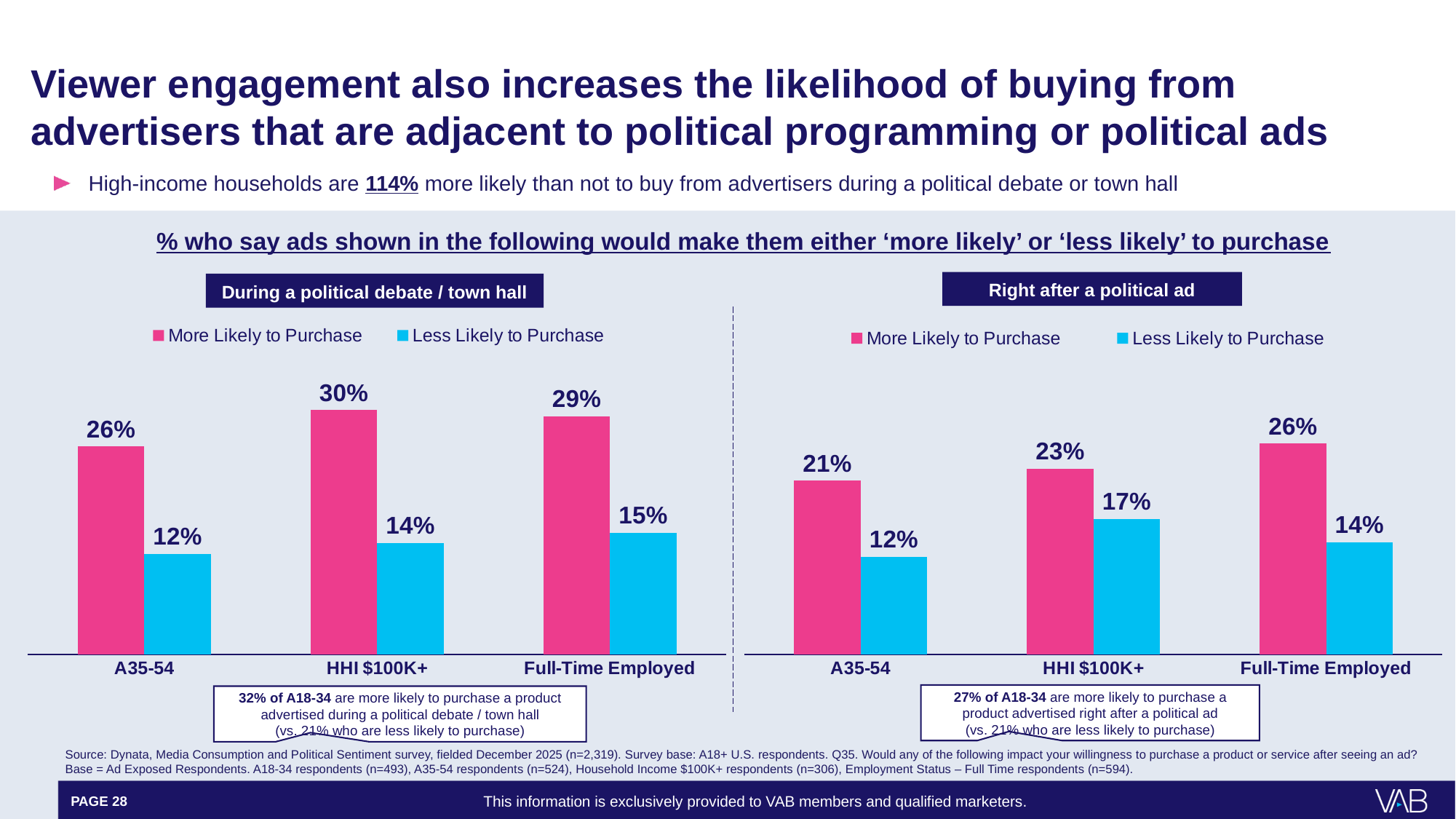
In the 'During a political debate / town hall' chart, what is the value for More Likely to Purchase for HHI $100K+? 30% Is the More Likely to Purchase value for HHI $100K+ larger in the 'During a political debate / town hall' chart or the 'Right after a political ad' chart? During a political debate / town hall In the 'Right after a political ad' chart, what is the difference between More Likely to Purchase and Less Likely to Purchase for A35-54? 9% What kind of chart is the 'Right after a political ad' chart? Bar chart In the 'Right after a political ad' chart, which category has the highest More Likely to Purchase value? Full-Time Employed In the 'During a political debate / town hall' chart, what is the value for Less Likely to Purchase for A35-54? 12% In the 'During a political debate / town hall' chart, what is the difference between More Likely to Purchase and Less Likely to Purchase for Full-Time Employed? 14% How many series does the legend of the 'During a political debate / town hall' chart list? 2 In the 'During a political debate / town hall' chart, which category has the lowest Less Likely to Purchase value? A35-54 In the 'Right after a political ad' chart, what is the value for Less Likely to Purchase for HHI $100K+? 17% How many categories are shown on the x axis of the 'Right after a political ad' chart? 3 In the 'Right after a political ad' chart, which colour represents Less Likely to Purchase? Light blue